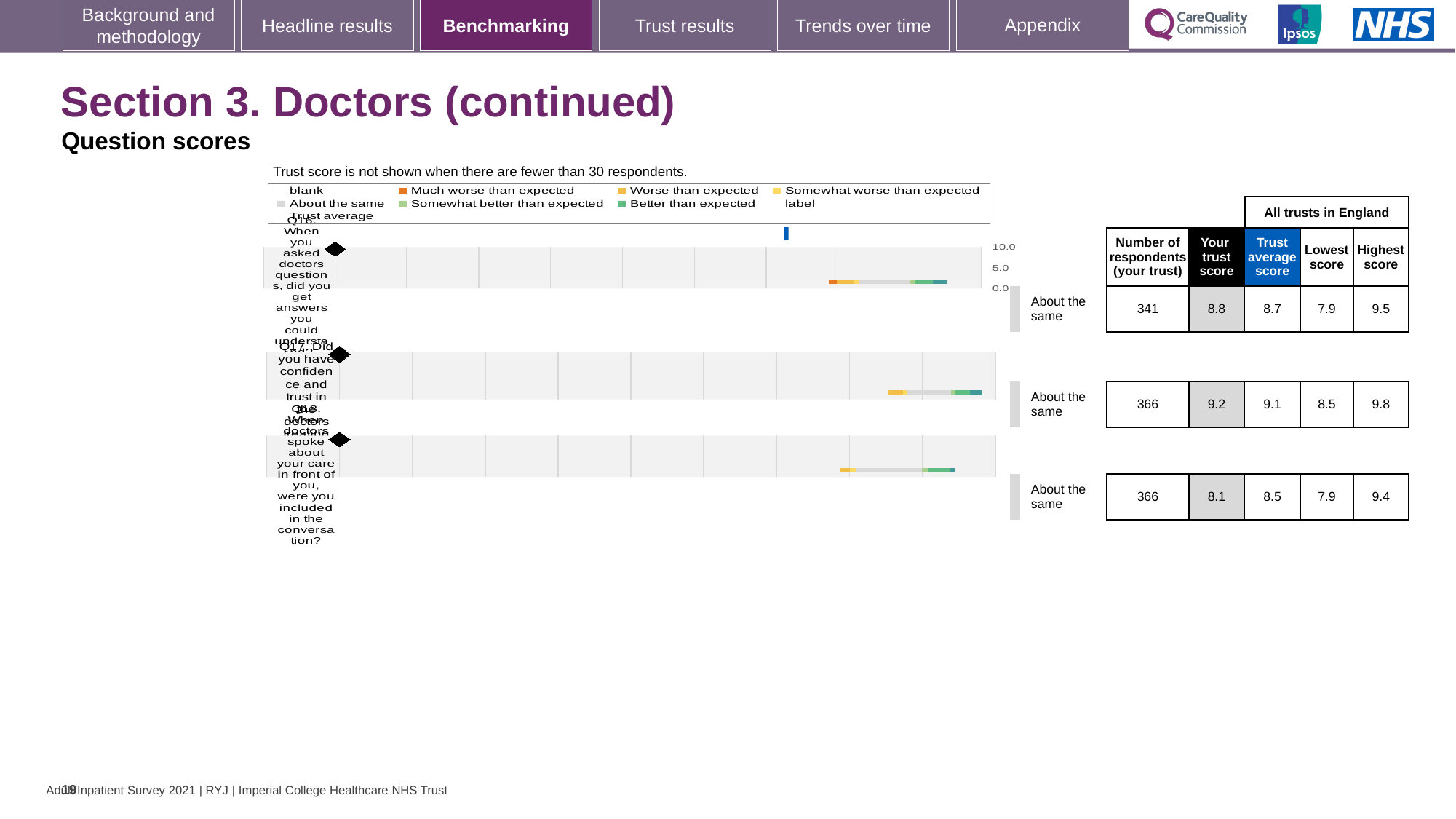
What is the 'Your trust score' for Q16 (When you asked doctors questions, did you get answers you could understand?)? 8.8 What is the highest score across all trusts in England for Q17? 9.8 Which question has the highest 'Your trust score'? Q17 How many questions (categories) are plotted in the question scores chart? 3 For Q16, which is larger: your trust score or the trust average score? Your trust score Which question has the lowest 'Your trust score'? Q18 What is the 'Your trust score' for Q17 (Did you have confidence and trust in the doctors treating you?)? 9.2 How many respondents from your trust answered Q16? 341 What is the 'Your trust score' for Q18 (When doctors spoke about your care in front of you, were you included in the conversation?)? 8.1 For Q18, what is the difference between the trust average score and your trust score? 0.4 What kind of chart is used to show the question scores on this slide? bar chart What benchmark category is shown for all three questions on this slide? About the same